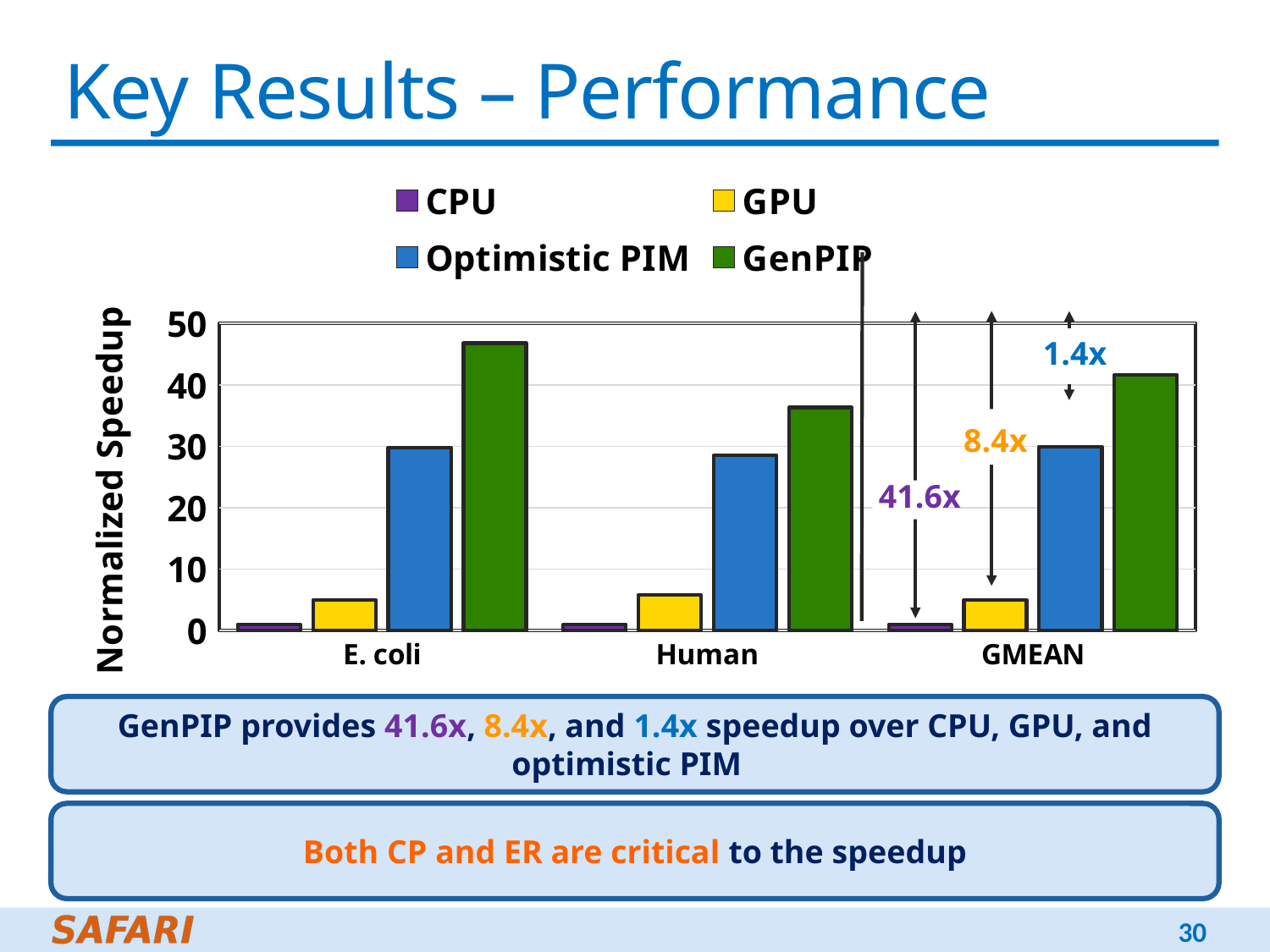
How many categories are shown on the x axis of the chart? 3 Is the GPU value for E. coli greater or less than 10? less Which series has the lowest bar in every category? CPU What kind of chart is shown on the slide? bar chart What speedup of GenPIP over CPU is annotated on the chart at GMEAN? 41.6x For Human, which is larger: the GenPIP bar or the Optimistic PIM bar? GenPIP Is the GenPIP value for Human greater or less than 30? greater How many series does the chart's legend list? 4 Which category has the highest GenPIP bar? E. coli Is the GenPIP value for GMEAN greater or less than 30? greater What is the label of the y axis of the chart? Normalized Speedup